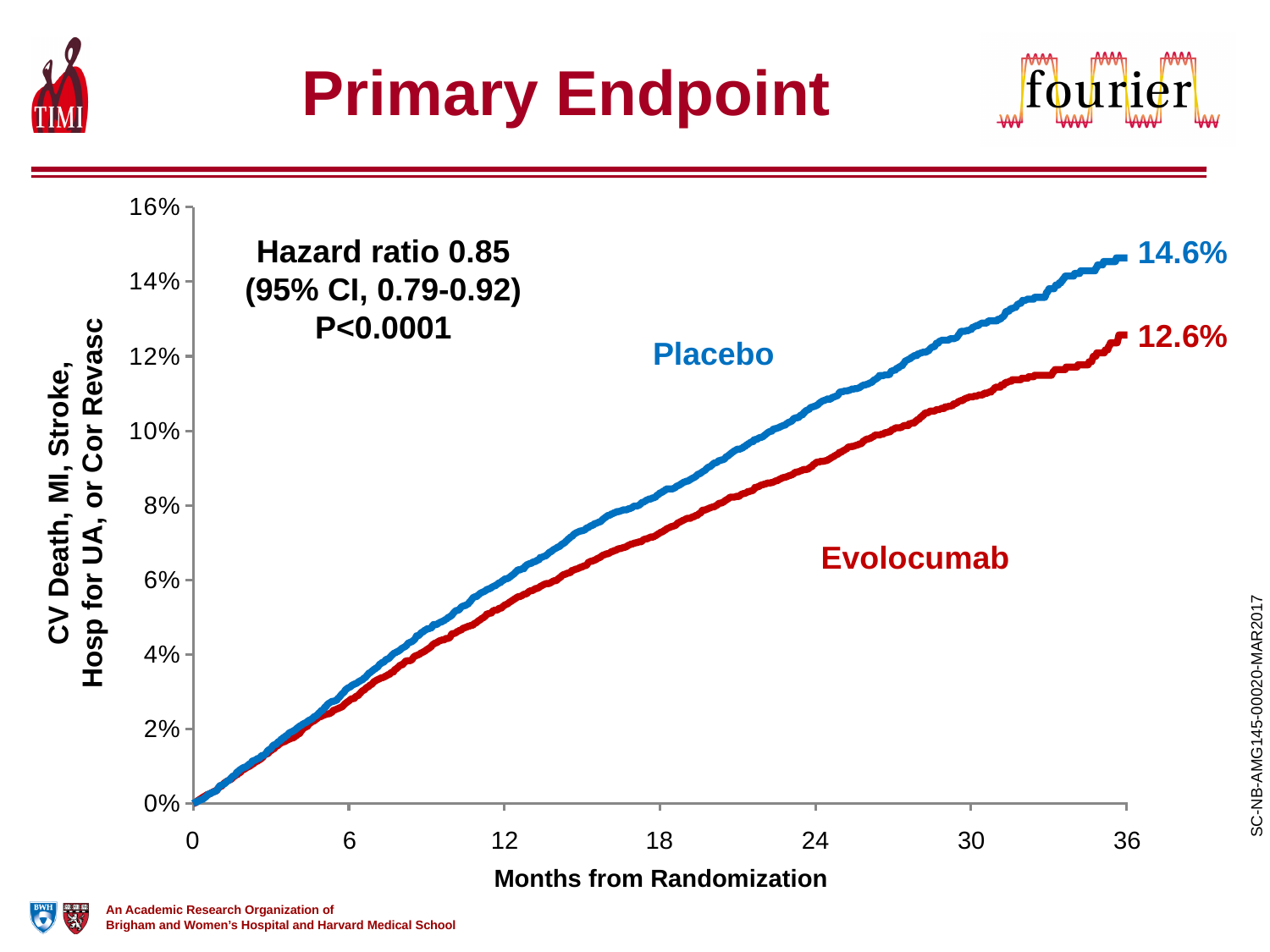
Do the values for both series rise or fall as months from randomization increase? Rise Is the value for Evolocumab at 24 months greater or less than 10%? less What is the value for Placebo at 36 months? 14.6% Which group has the higher event rate at 36 months, Placebo or Evolocumab? Placebo Is the value for Evolocumab at 12 months greater or less than 6%? less What is the difference between the Placebo and Evolocumab values at 36 months? 2.0% Is the value for Evolocumab at 30 months greater or less than 10%? greater What kind of chart is shown on the slide? Line chart What hazard ratio is reported on the chart? 0.85 How many series are plotted on the chart? 2 Which series reaches the lowest value at 36 months? Evolocumab What is the value for Evolocumab at 36 months? 12.6%